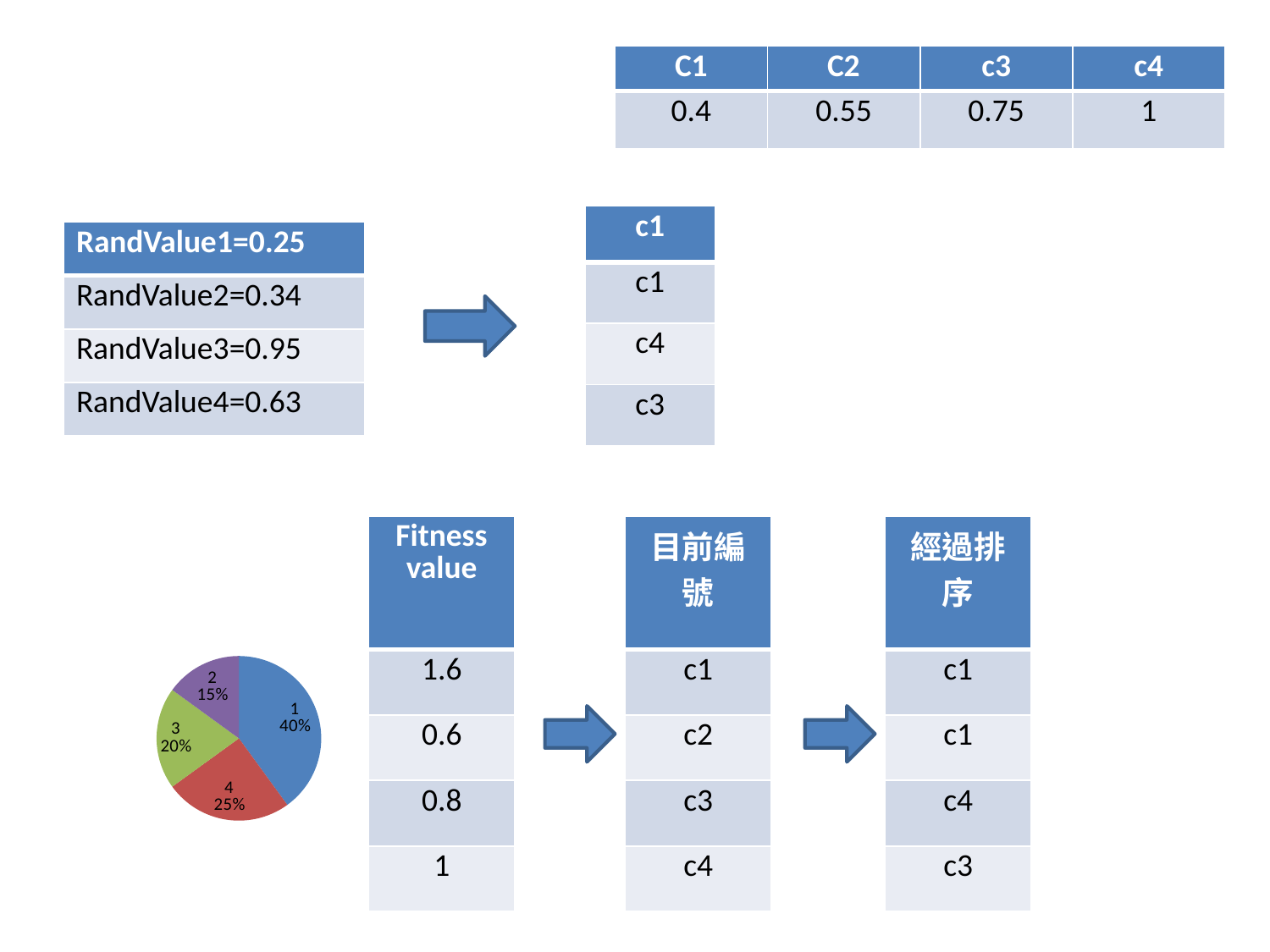
What colour is slice 1 in the pie chart? blue What kind of chart is shown at the bottom left of the slide? pie chart Which slice of the pie chart is the smallest? 2 What share of the pie chart does slice 1 have? 40% In the pie chart, what is the difference in percentage points between slice 4 and slice 3? 5% What share of the pie chart does slice 4 have? 25% What share of the pie chart does slice 2 have? 15% In the pie chart, what is the difference in percentage points between slice 1 and slice 2? 25% In the pie chart, which slice is larger, slice 3 or slice 4? 4 Which slice of the pie chart is the largest? 1 How many slices does the pie chart have? 4